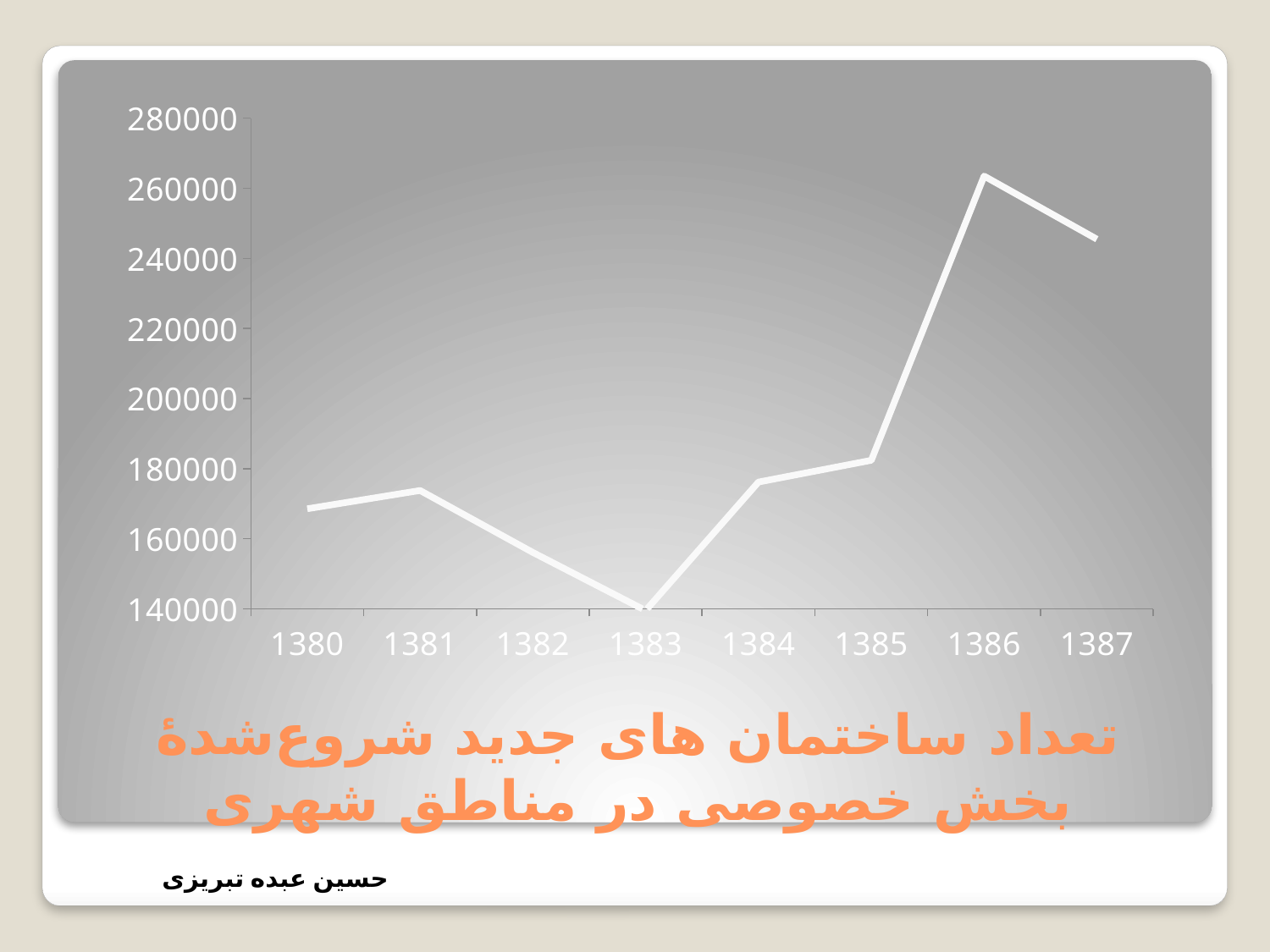
Which year has the highest value on the chart? 1386 Is the value for 1383 greater or less than 160000? less Which year has the larger value, 1386 or 1387? 1386 Which year has the lowest value on the chart? 1383 How many years are plotted along the x axis of the chart? 8 What kind of chart is shown on the slide? line chart Which year has the larger value, 1381 or 1382? 1381 Does the line rise or fall from 1381 to 1383? fall Is the value for 1385 greater or less than 200000? less Does the line rise or fall from 1383 to 1386? rise Is the value for 1386 greater or less than 240000? greater